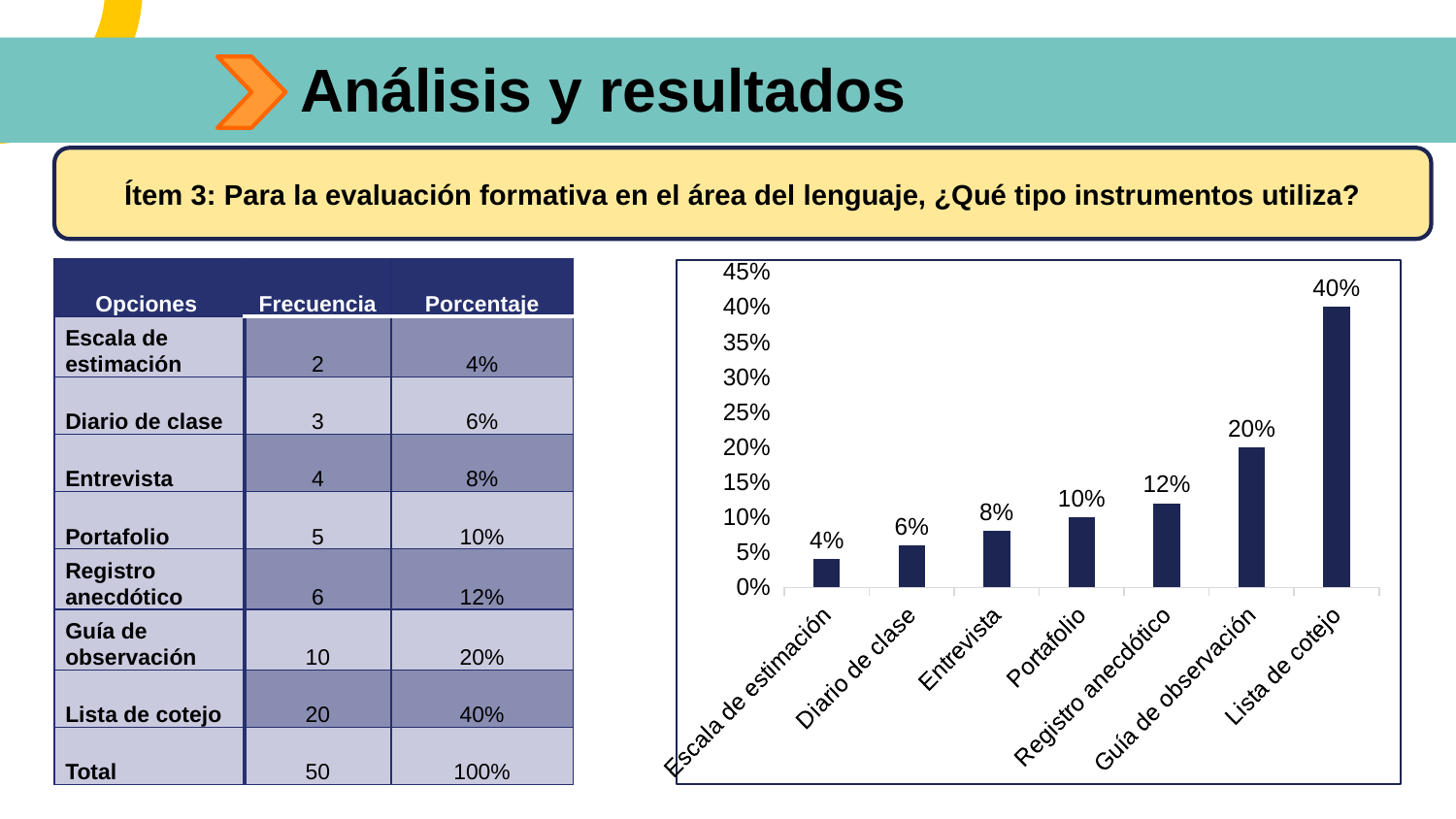
What is the difference between the values for Entrevista and Diario de clase? 2% Which category has the lowest value in the chart? Escala de estimación How many categories are shown in the chart? 7 Which is larger, the value for Guía de observación or the value for Registro anecdótico? Guía de observación Do the values rise or fall from left to right along the x axis? rise What is the value for Portafolio in the chart? 10% Which category has the highest value in the chart? Lista de cotejo Is the value for Lista de cotejo greater or less than 35%? greater What kind of chart is shown on the slide? bar chart What is the difference between the values for Lista de cotejo and Guía de observación? 20% What is the value for Registro anecdótico in the chart? 12% What is the value for Lista de cotejo in the chart? 40%